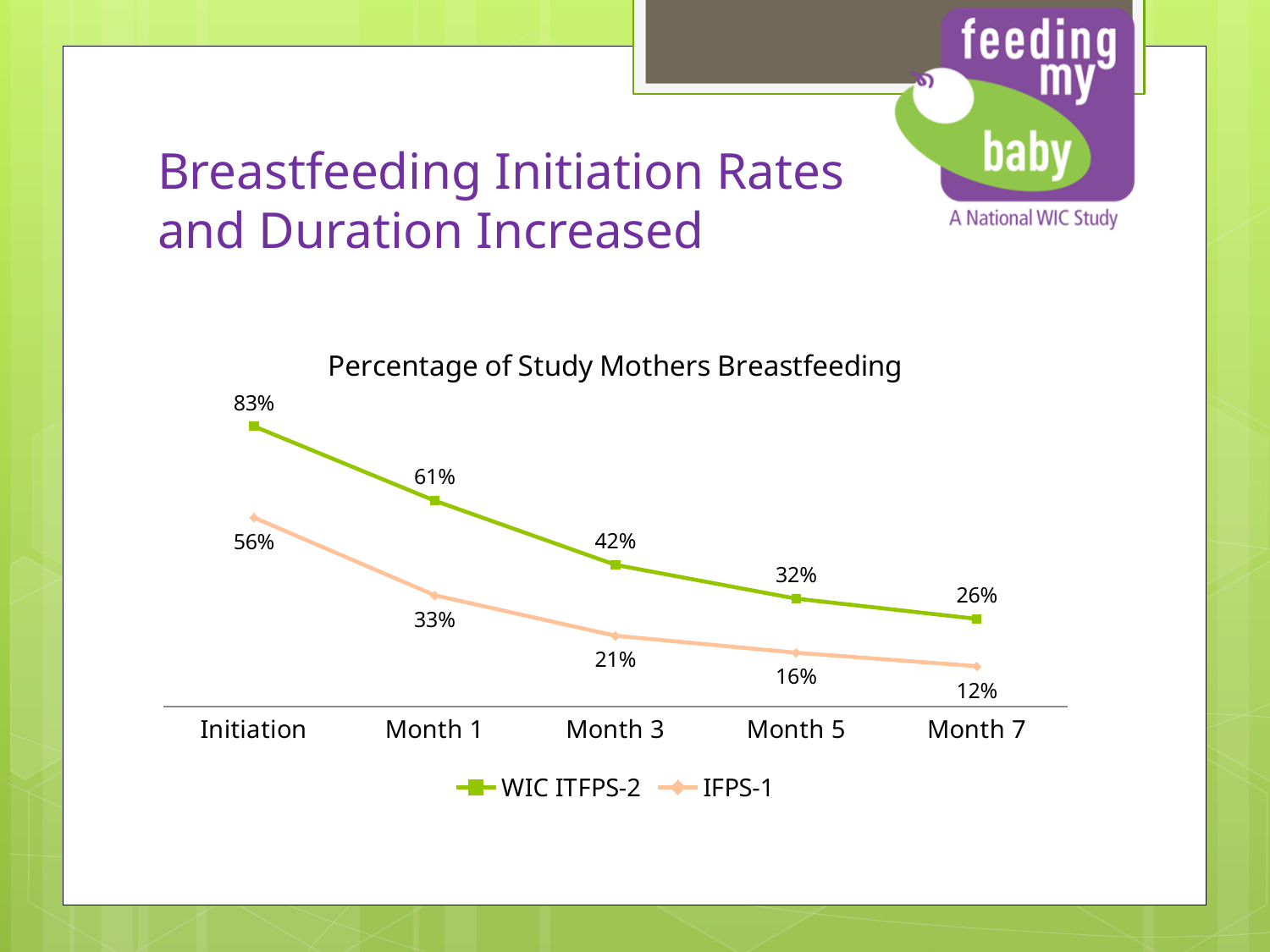
At which point on the x axis is the IFPS-1 series highest? Initiation What kind of chart is shown on the slide? Line chart How many series does the legend list? 2 What is the difference between the WIC ITFPS-2 and IFPS-1 values at Initiation? 27% What is the difference between the WIC ITFPS-2 and IFPS-1 values at Month 5? 16% At which point on the x axis is the WIC ITFPS-2 series lowest? Month 7 How many points are plotted along the x axis for each series? 5 What is the IFPS-1 value at Month 1? 33% Which series has the higher value at Month 1, WIC ITFPS-2 or IFPS-1? WIC ITFPS-2 What percentage of WIC ITFPS-2 study mothers were breastfeeding at Month 3? 42% What percentage of IFPS-1 study mothers were breastfeeding at Month 7? 12% What is the WIC ITFPS-2 value at Initiation? 83%